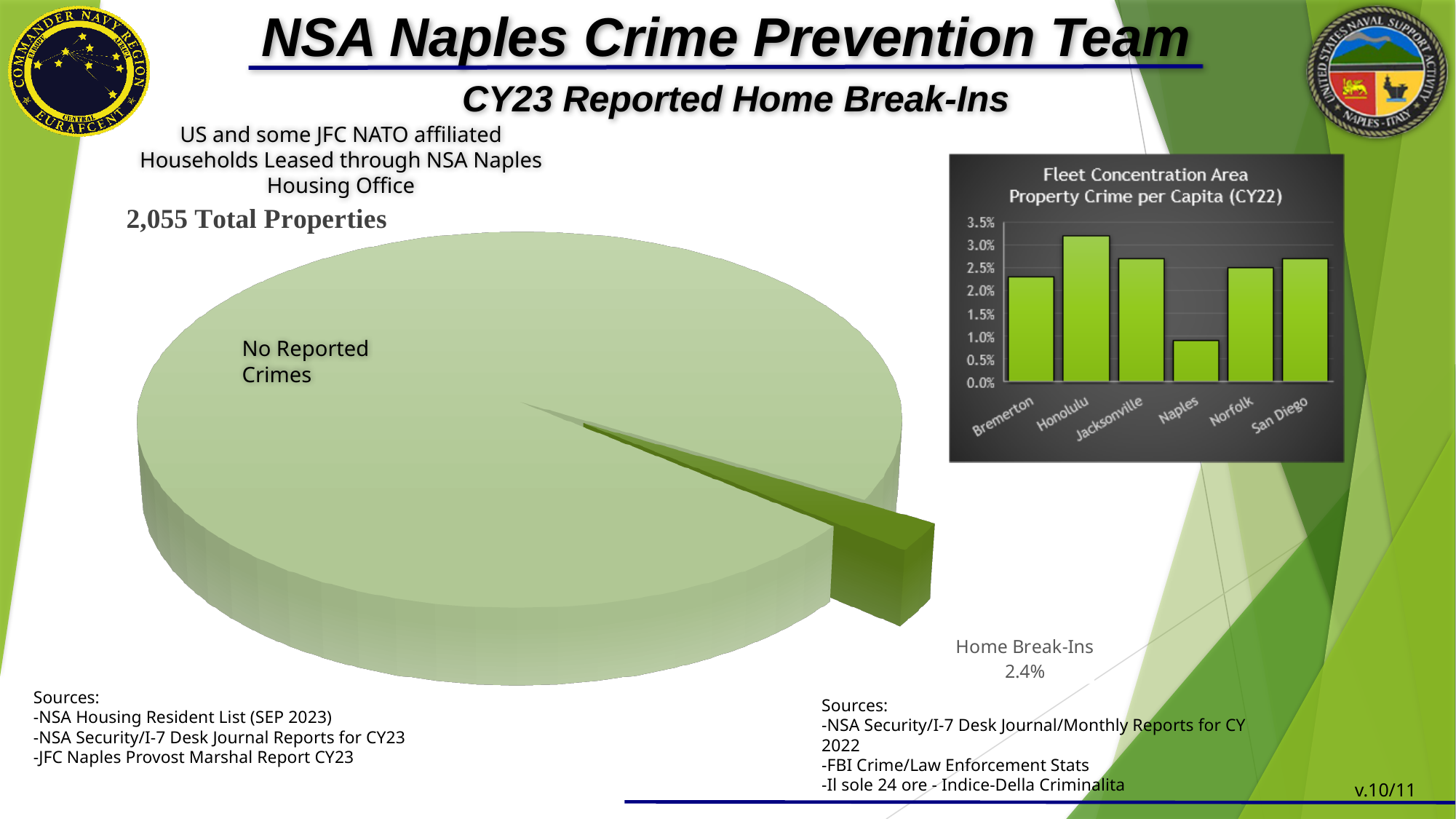
On the Fleet Concentration Area Property Crime per Capita (CY22) chart, is the value for Honolulu greater or less than 3.0%? greater On the pie chart, what share of properties had reported home break-ins? 2.4% On the Fleet Concentration Area Property Crime per Capita (CY22) chart, which location has the lowest value? Naples On the Fleet Concentration Area Property Crime per Capita (CY22) chart, which has the larger value, Bremerton or Honolulu? Honolulu What is the total number of properties stated above the pie chart? 2,055 Total Properties What kind of chart is the chart on the left of the slide? Pie chart What kind of chart is the Fleet Concentration Area Property Crime per Capita (CY22) chart? Bar chart On the Fleet Concentration Area Property Crime per Capita (CY22) chart, which location has the highest value? Honolulu How many locations are shown on the Fleet Concentration Area Property Crime per Capita (CY22) chart? 6 On the pie chart, what is the label of the large slice? No Reported Crimes How many slices does the pie chart have? 2